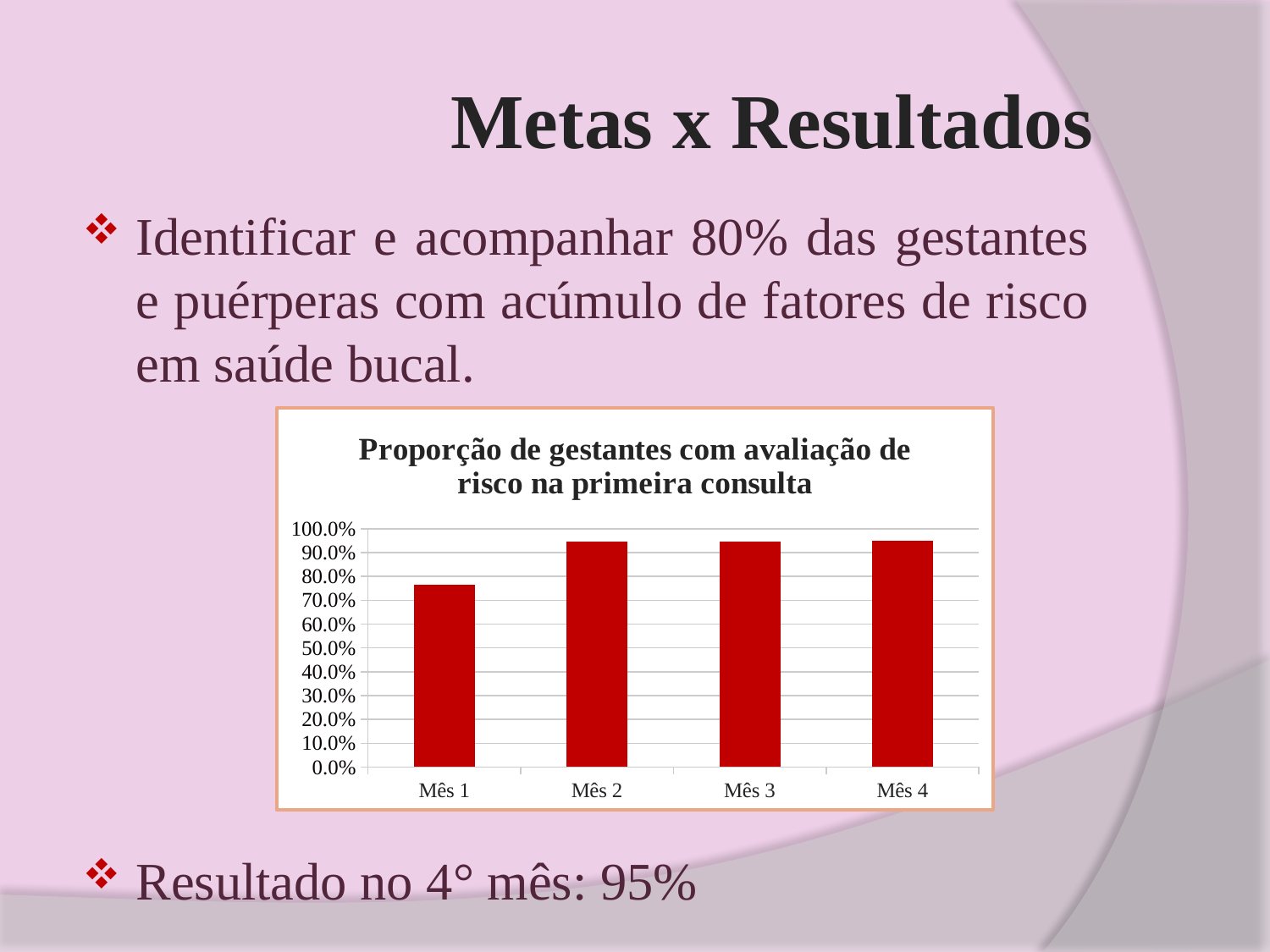
Is the value for Mês 1 greater or less than 70.0%? greater Which month has the lowest proportion in the chart? Mês 1 Which is larger, the value for Mês 3 or the value for Mês 1? Mês 3 What is the title of the chart? Proporção de gestantes com avaliação de risco na primeira consulta According to the slide, what is the result in the 4th month (Mês 4)? 95% How many months (categories) are shown on the x axis of the chart? 4 Which is larger, the value for Mês 1 or the value for Mês 2? Mês 2 Is the value for Mês 4 greater or less than 90.0%? greater What is the highest value shown on the chart's y axis? 100.0% What kind of chart is shown on the slide? bar chart Is the value for Mês 2 greater or less than 90.0%? greater